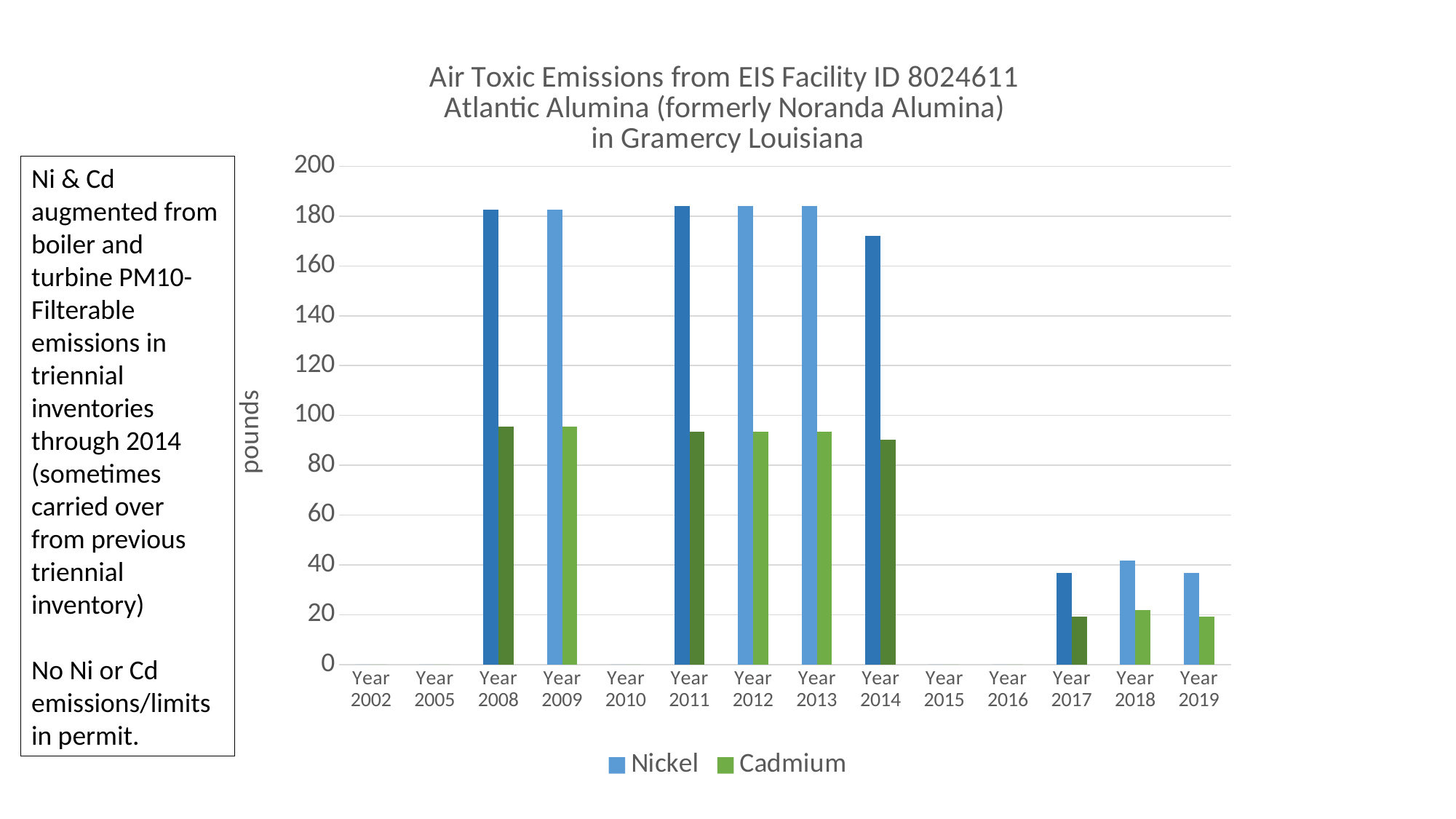
How many year categories are shown on the x axis? 14 How many series does the legend list? 2 What is the label on the y axis? pounds Is the Nickel value for Year 2008 greater or less than 160? greater Is the Nickel value for Year 2017 greater or less than 40? less What kind of chart is shown on the slide? bar chart Is the Cadmium value for Year 2014 greater or less than 100? less Which is larger in Year 2012, the Nickel value or the Cadmium value? Nickel Do the Nickel values rise or fall from Year 2014 to Year 2017? fall Which is larger, the Nickel value for Year 2013 or the Nickel value for Year 2014? Year 2013 Which series is shown in green? Cadmium